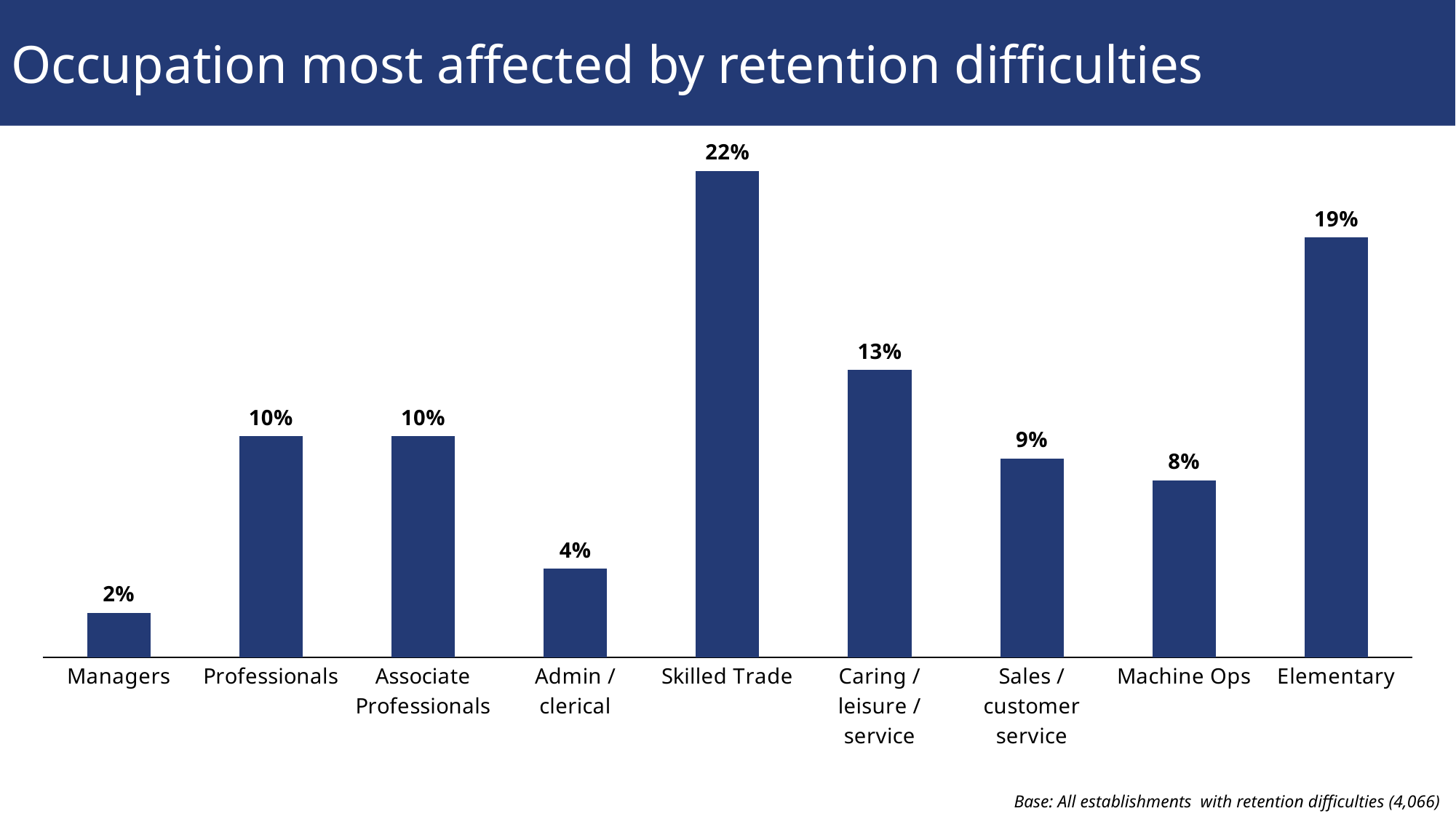
Which is larger, the value for Sales / customer service or the value for Machine Ops? Sales / customer service What is the difference between the values for Caring / leisure / service and Admin / clerical? 9% What is the title of the chart? Occupation most affected by retention difficulties What is the value for Machine Ops? 8% What is the value for Managers? 2% Which occupation has the highest value? Skilled Trade What kind of chart is shown on the slide? Bar chart How many occupation categories are shown on the chart? 9 What is the value for Skilled Trade? 22% What is the difference between the values for Skilled Trade and Elementary? 3% Which occupation has the lowest value? Managers What is the value for Caring / leisure / service? 13%